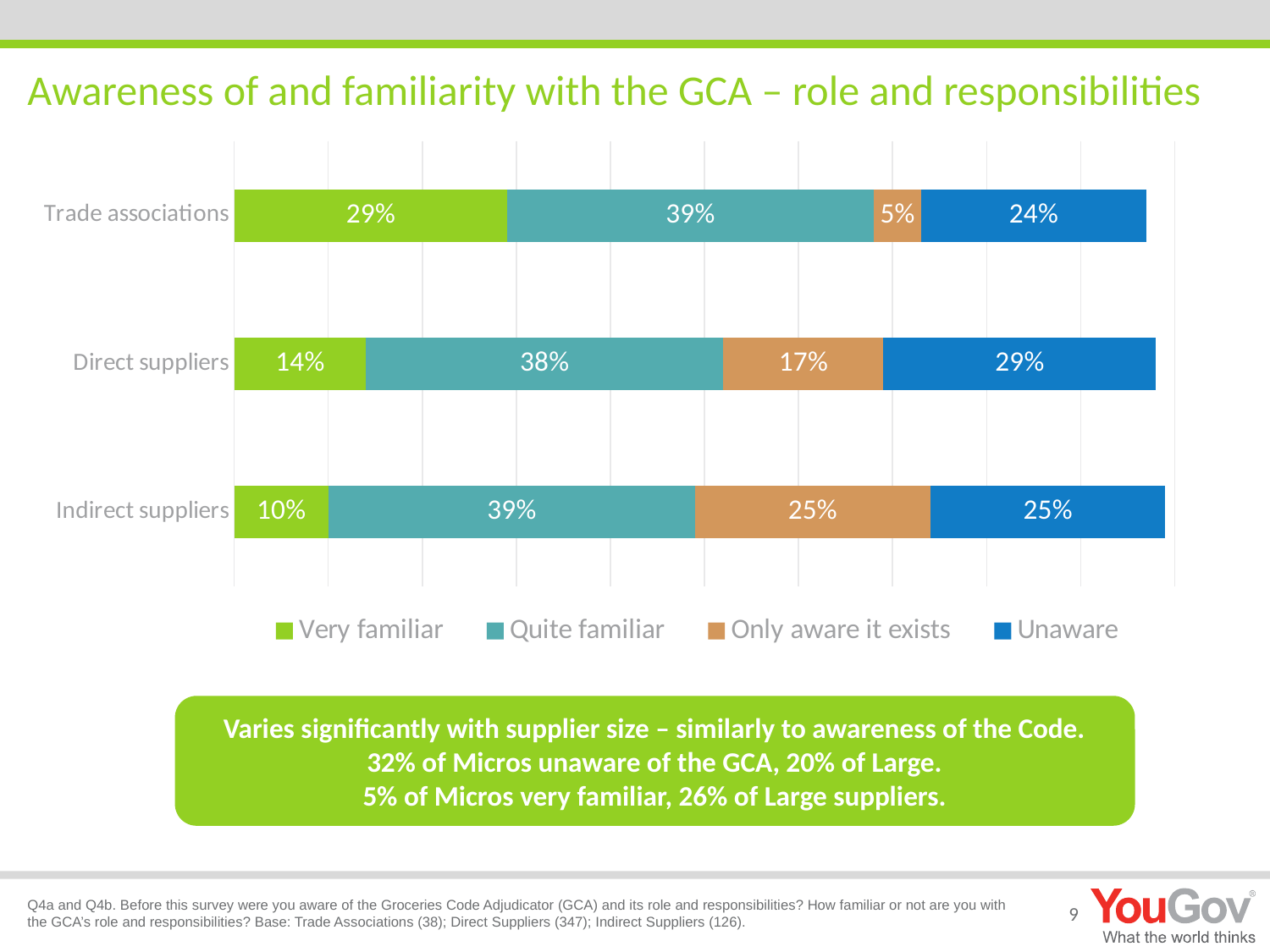
Which category has the highest 'Very familiar' value? Trade associations Which is larger: the 'Very familiar' value for Direct suppliers or for Indirect suppliers? Direct suppliers Which category has the lowest 'Only aware it exists' value? Trade associations What is the difference between the 'Unaware' values for Direct suppliers and Trade associations? 5% What is the 'Only aware it exists' value for Direct suppliers? 17% How many categories are shown on the chart? 3 What is the total of the stacked bar for Indirect suppliers? 99% Which legend entry is shown in orange? Only aware it exists What kind of chart is shown on the slide? Stacked bar chart What is the 'Very familiar' value for Trade associations? 29% What is the 'Unaware' value for Indirect suppliers? 25% How many series does the legend list? 4